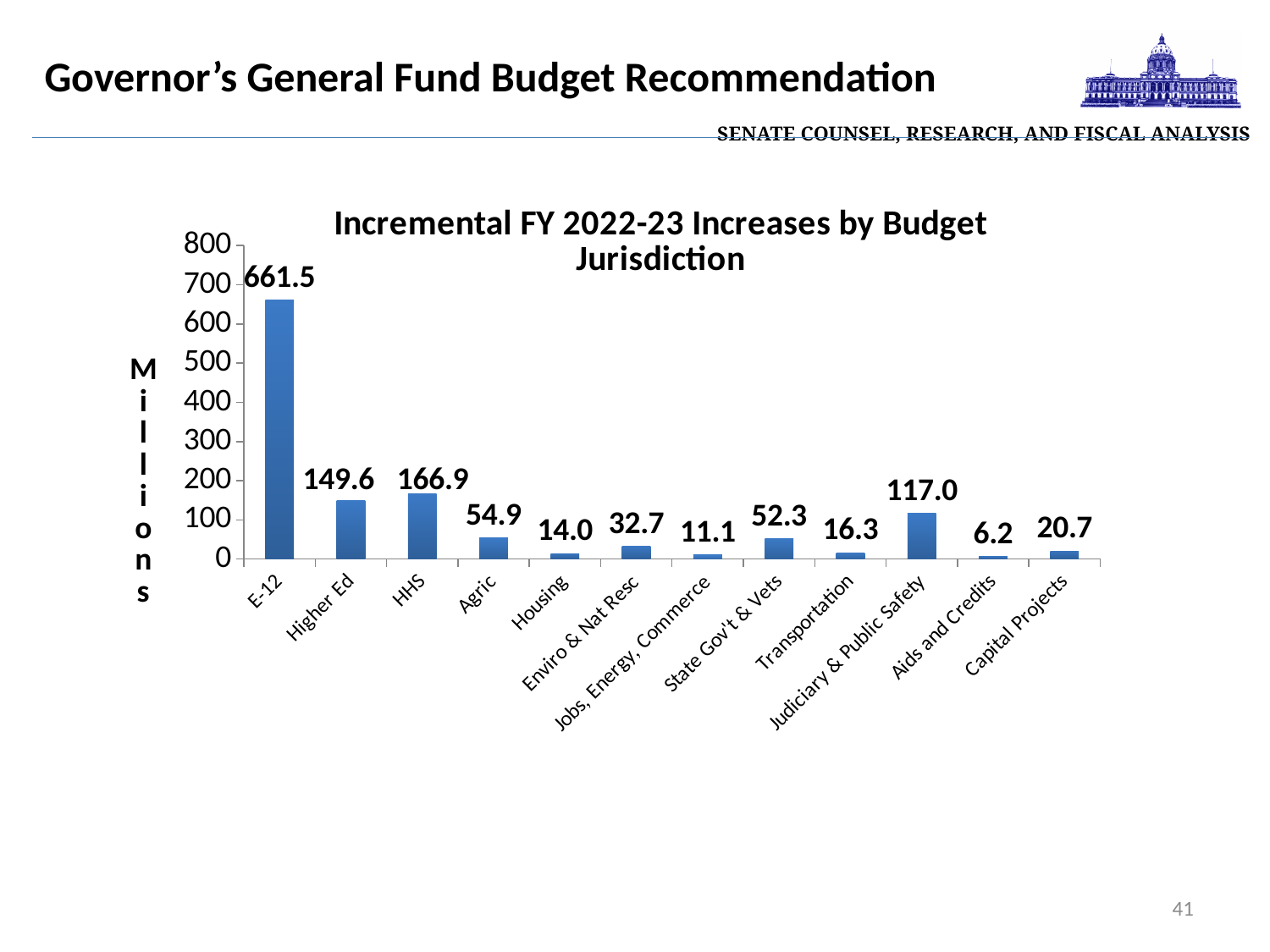
What is the label on the vertical axis? Millions What is the value for Judiciary & Public Safety? 117.0 What is the value for Aids and Credits? 6.2 Is the value for Higher Ed greater or less than 100? greater What is the difference between the values for HHS and Higher Ed? 17.3 Which budget jurisdiction has the highest value? E-12 Which is larger, the value for Agric or the value for State Gov't & Vets? Agric Which budget jurisdiction has the lowest value? Aids and Credits What is the value for E-12? 661.5 What is the title of the chart? Incremental FY 2022-23 Increases by Budget Jurisdiction How many budget jurisdictions are shown on the x axis? 12 What kind of chart is shown on the slide? Bar chart